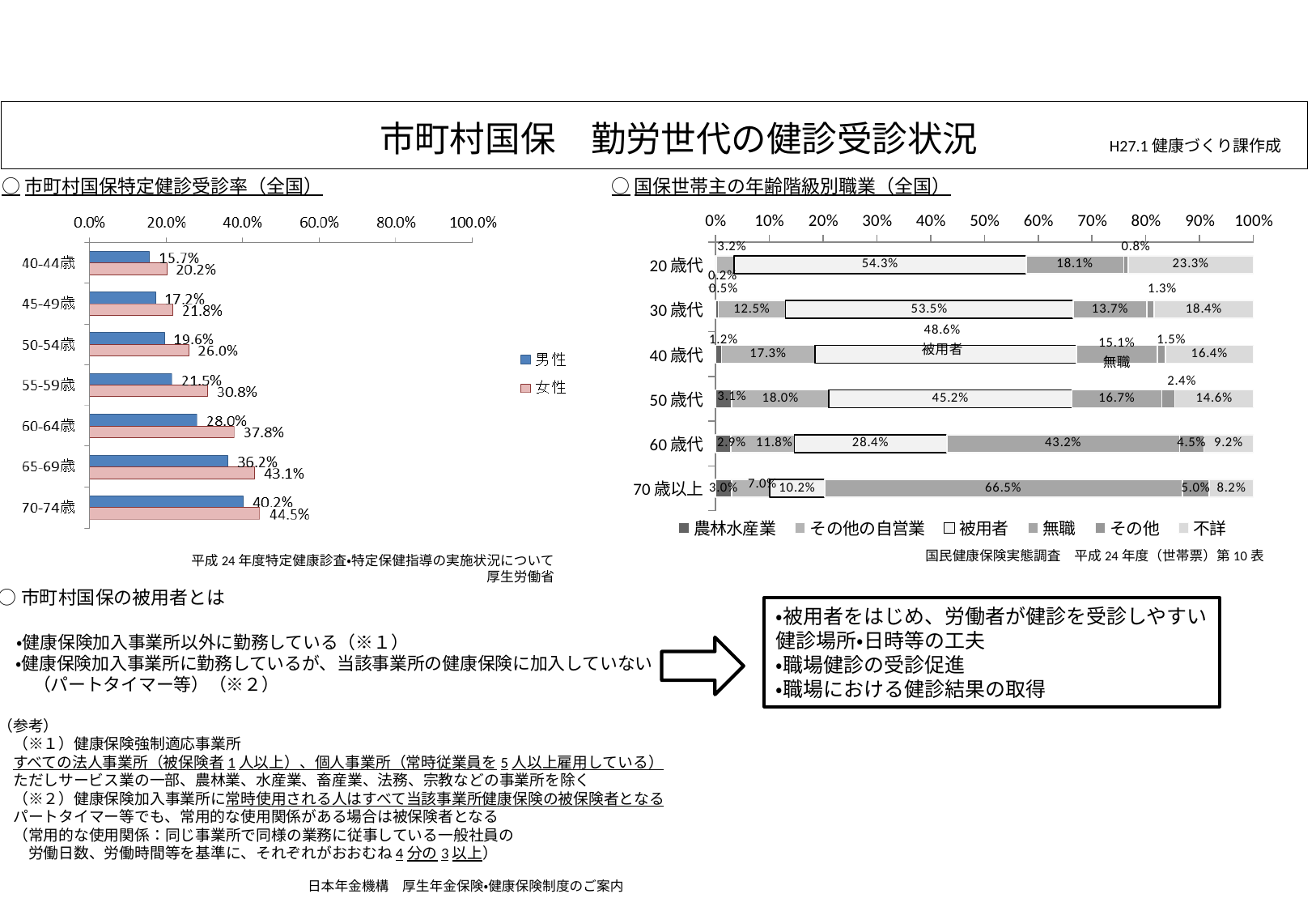
In the left chart (市町村国保特定健診受診率（全国）), how many age groups are shown? 7 In the right chart (国保世帯主の年齢階級別職業（全国）), which age group has the highest 無職 share? 70歳以上 In the right chart (国保世帯主の年齢階級別職業（全国）), how many series does the legend list? 6 What kind of chart is the right chart (国保世帯主の年齢階級別職業（全国）)? stacked bar chart In the left chart (市町村国保特定健診受診率（全国）), which age group has the lowest value for 女性? 40-44歳 In the right chart (国保世帯主の年齢階級別職業（全国）), what is the 被用者 share for 40歳代? 48.6% In the left chart (市町村国保特定健診受診率（全国）), which age group has the highest value for 男性? 70-74歳 In the left chart (市町村国保特定健診受診率（全国）), do the 男性 values rise or fall as the age groups go from 40-44歳 to 70-74歳? rise In the left chart (市町村国保特定健診受診率（全国）), what is the value for 男性 in the 60-64歳 group? 28.0% In the left chart (市町村国保特定健診受診率（全国）), what is the value for 女性 in the 55-59歳 group? 30.8% In the right chart (国保世帯主の年齢階級別職業（全国）), what is the 無職 share for 70歳以上? 66.5% In the left chart (市町村国保特定健診受診率（全国）), what is the difference between the 女性 and 男性 values for the 50-54歳 group? 6.4%